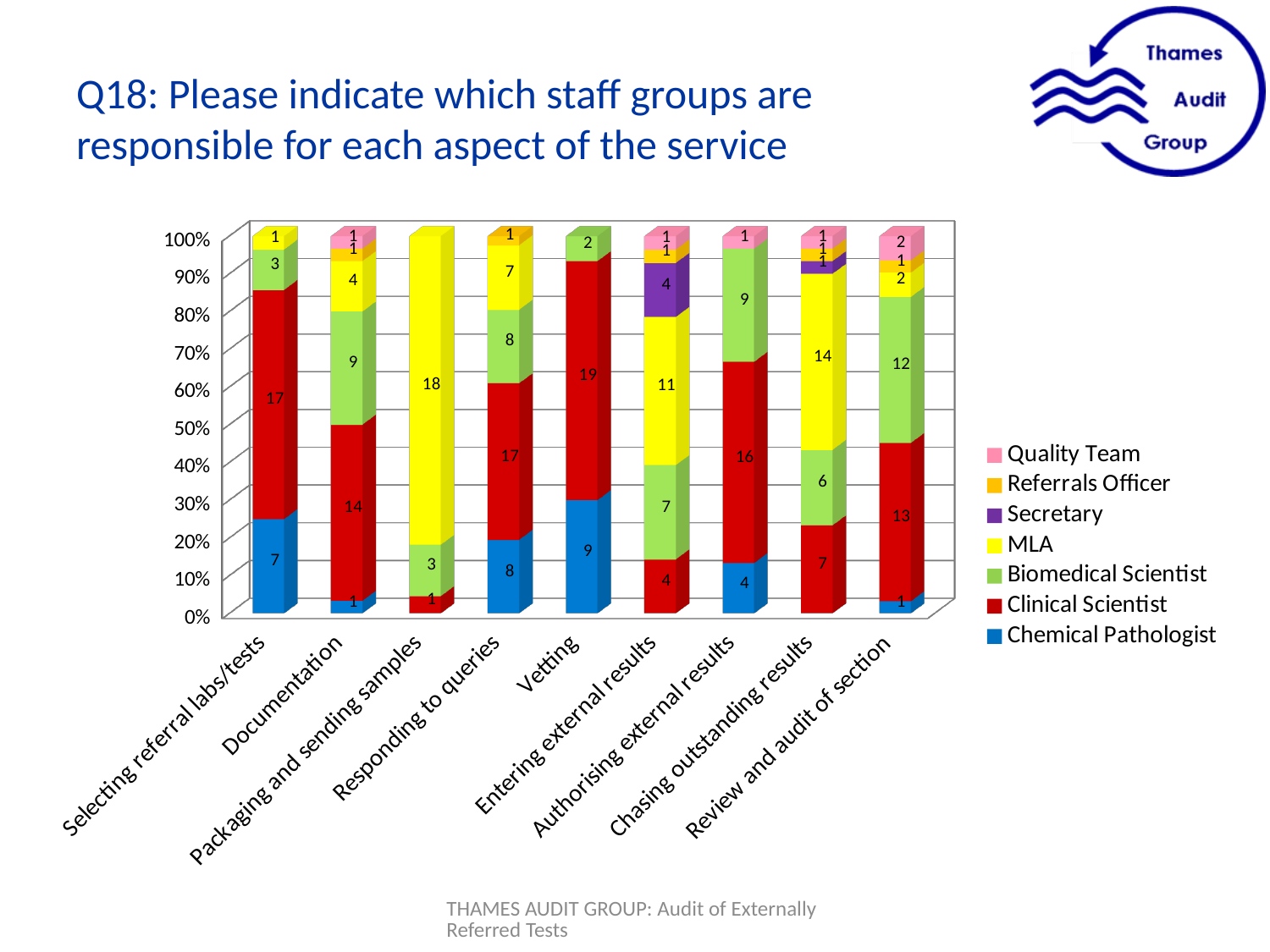
What kind of chart is shown on the slide? Stacked bar chart Which is larger: the Chemical Pathologist value for Vetting or for Authorising external results? Vetting What is the Biomedical Scientist value for Review and audit of section? 12 What is the MLA value for Packaging and sending samples? 18 What is the difference between the MLA values for Packaging and sending samples and Chasing outstanding results? 4 How many service aspects (categories) are shown on the x axis? 9 How many staff groups does the legend list? 7 What is the Chemical Pathologist value for Responding to queries? 8 Which category has the highest Clinical Scientist value? Vetting What is the Clinical Scientist value for Vetting? 19 What is the Secretary value for Entering external results? 4 What is the total of all segments in the Vetting bar? 30